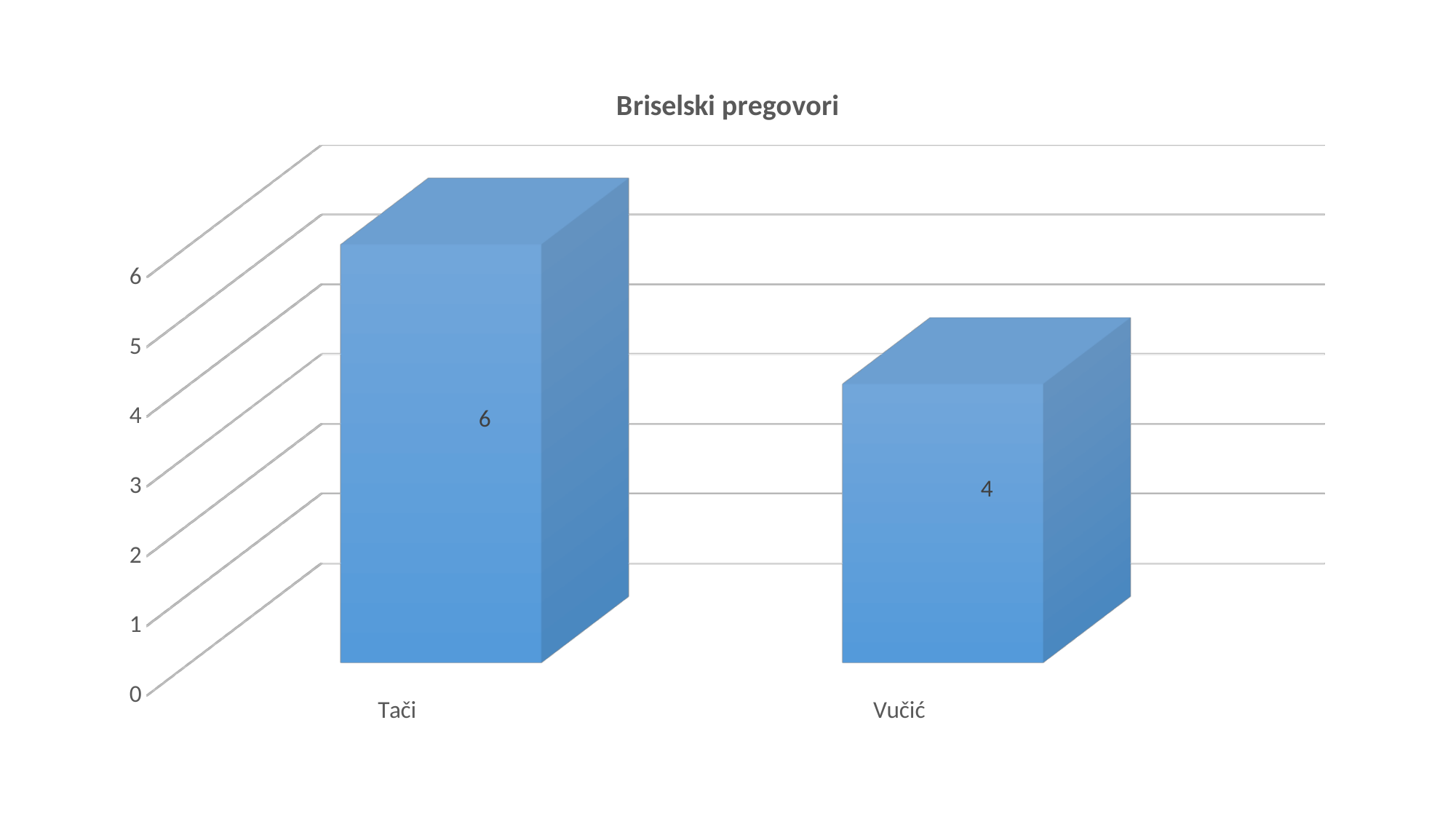
What kind of chart is shown on the slide? bar chart What is the highest value shown on the vertical axis? 6 Which is larger, the value for Tači or the value for Vučić? Tači What is the title of the chart? Briselski pregovori Which category has the highest value? Tači Is the value for Vučić greater or less than 5? less Is the value for Tači greater or less than 5? greater What is the value for Vučić? 4 What is the difference between the values for Tači and Vučić? 2 How many categories are shown on the chart? 2 What is the value for Tači? 6 Which category has the lowest value? Vučić